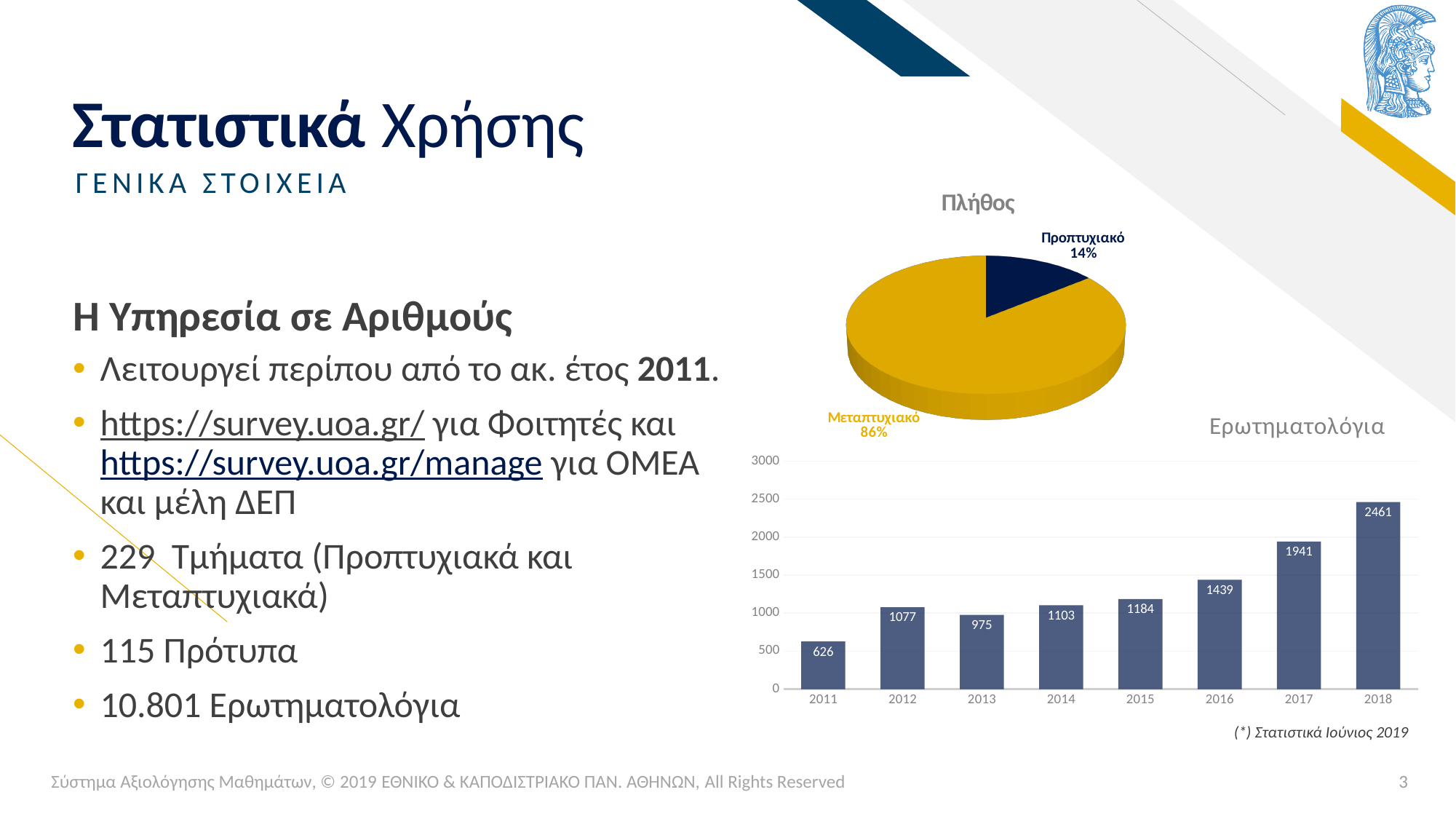
What kind of chart is the 'Ερωτηματολόγια' chart? Bar chart In the 'Ερωτηματολόγια' bar chart, what is the value for 2011? 626 How many years are shown in the 'Ερωτηματολόγια' bar chart? 8 In the 'Ερωτηματολόγια' bar chart, which is larger, the value for 2012 or the value for 2013? 2012 In the 'Ερωτηματολόγια' bar chart, which year has the highest value? 2018 In the 'Ερωτηματολόγια' bar chart, what is the value for 2015? 1184 What kind of chart is the 'Πλήθος' chart? Pie chart In the 'Πλήθος' pie chart, what share does 'Μεταπτυχιακό' have? 86% In the 'Ερωτηματολόγια' bar chart, what is the difference between the values for 2018 and 2017? 520 In the 'Ερωτηματολόγια' bar chart, what is the value for 2018? 2461 In the 'Ερωτηματολόγια' bar chart, which year has the lowest value? 2011 In the 'Πλήθος' pie chart, what share does 'Προπτυχιακό' have? 14%